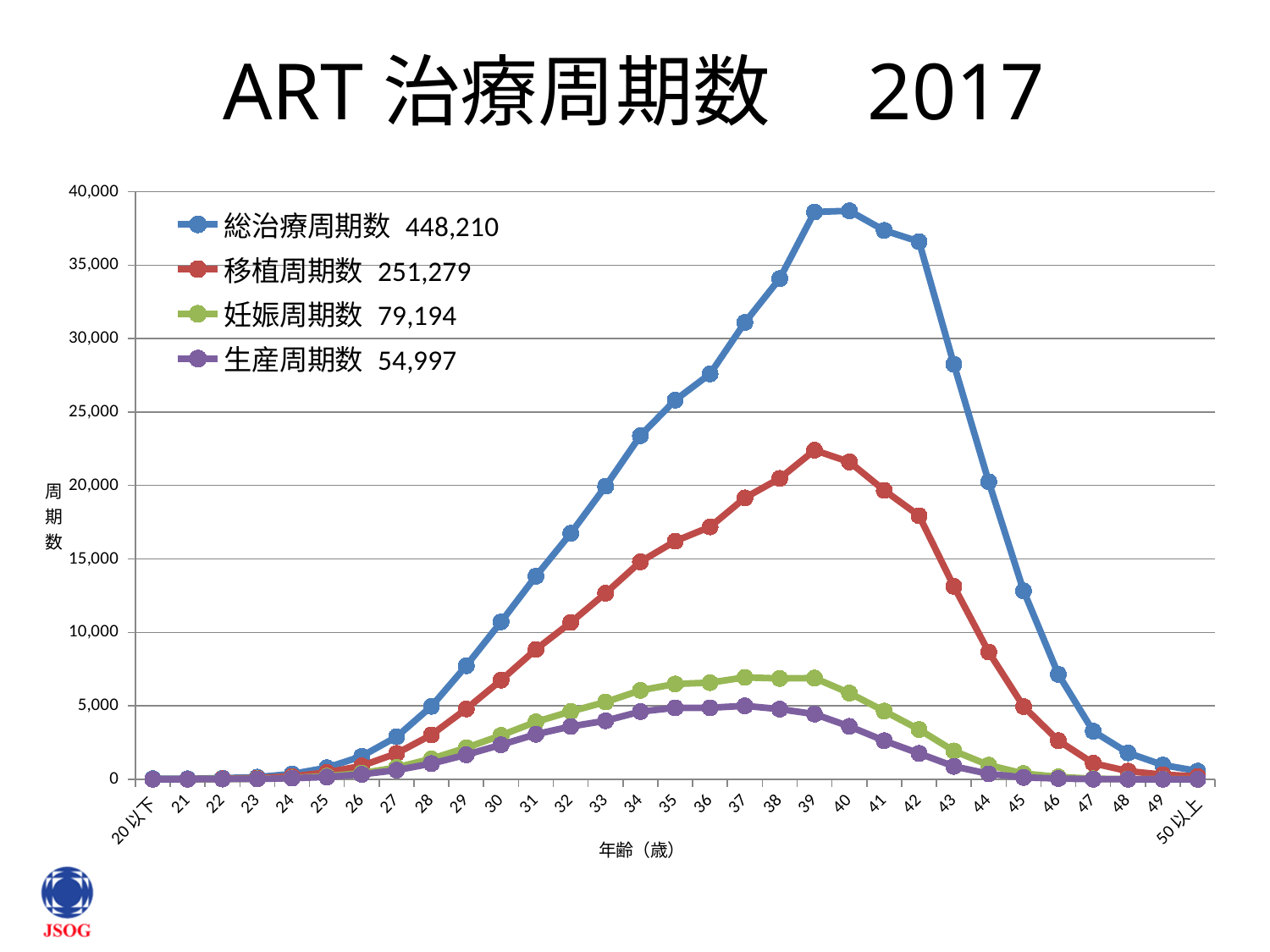
What total is printed next to 生産周期数 in the legend? 54,997 What total is printed next to 総治療周期数 in the legend? 448,210 What total is printed next to 移植周期数 in the legend? 251,279 What total is printed next to 妊娠周期数 in the legend? 79,194 How many age categories are shown on the x axis? 31 Is the value for 妊娠周期数 at age 37 greater or less than 10,000? less At age 43, which is larger: 総治療周期数 or 移植周期数? 総治療周期数 How many series does the legend list? 4 What kind of chart is shown on the slide? line chart What is the label of the x axis? 年齢（歳） What is the difference between the legend totals for 総治療周期数 and 移植周期数? 196,931 Is the value for 総治療周期数 at age 40 greater or less than 35,000? greater